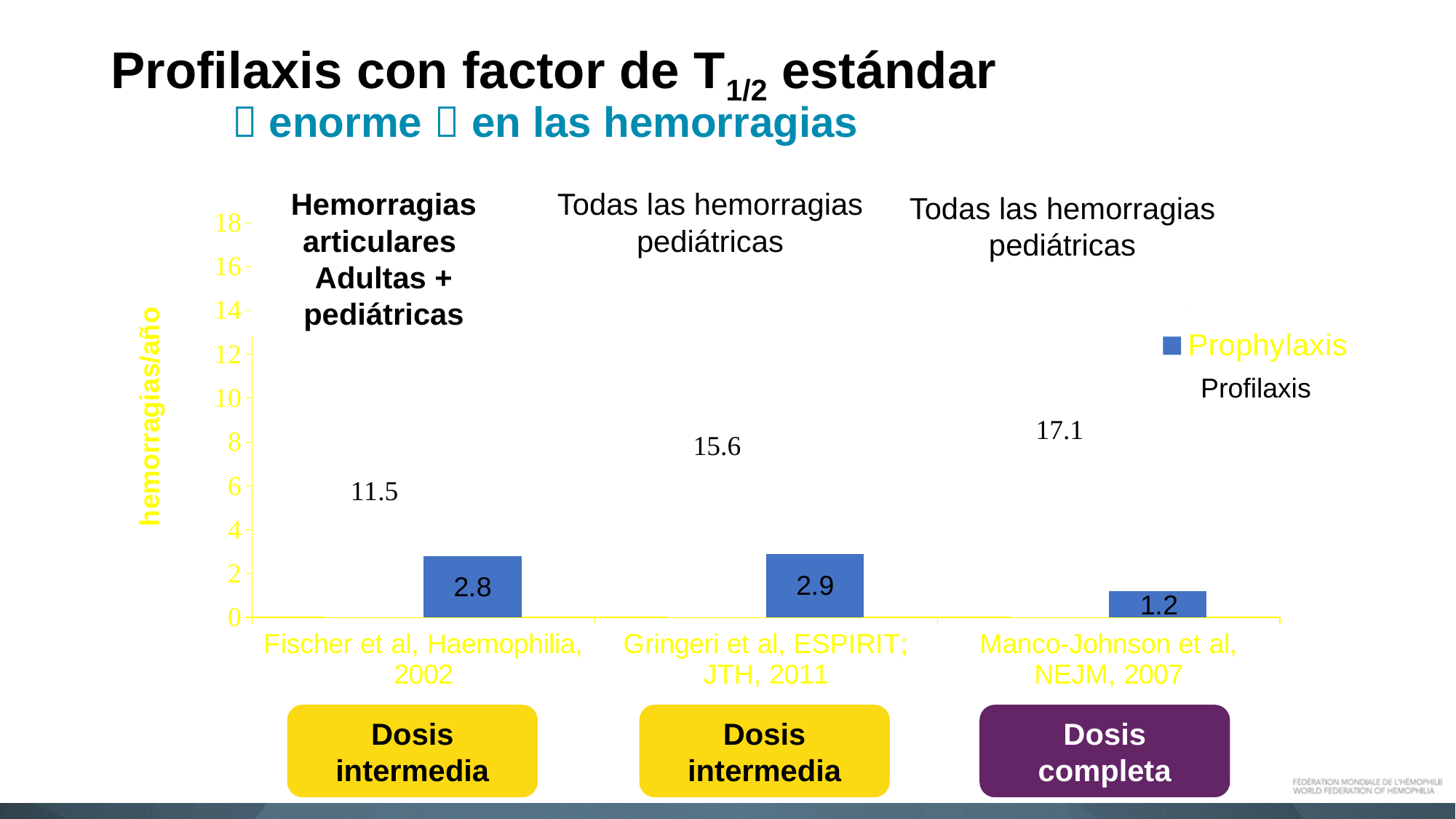
Is the Prophylaxis bar value for Manco-Johnson et al, NEJM, 2007 greater or less than 2? less How many studies (categories) are shown on the x axis of the chart? 3 Which has a larger Prophylaxis bar value: Fischer et al, 2002 or Manco-Johnson et al, 2007? Fischer et al, 2002 What is the difference between the Prophylaxis bar values for Fischer et al, 2002 and Manco-Johnson et al, 2007? 1.6 What is the value of the Prophylaxis bar for Fischer et al, Haemophilia, 2002? 2.8 How many series does the chart legend list? 1 Which study has the lowest Prophylaxis bar value? Manco-Johnson et al, NEJM, 2007 Which study has the highest Prophylaxis bar value? Gringeri et al, ESPIRIT; JTH, 2011 What kind of chart is shown on the slide? bar chart What is the value of the Prophylaxis bar for Manco-Johnson et al, NEJM, 2007? 1.2 What is the value of the Prophylaxis bar for Gringeri et al, ESPIRIT; JTH, 2011? 2.9 What is the label of the y axis of the chart? hemorragias/año